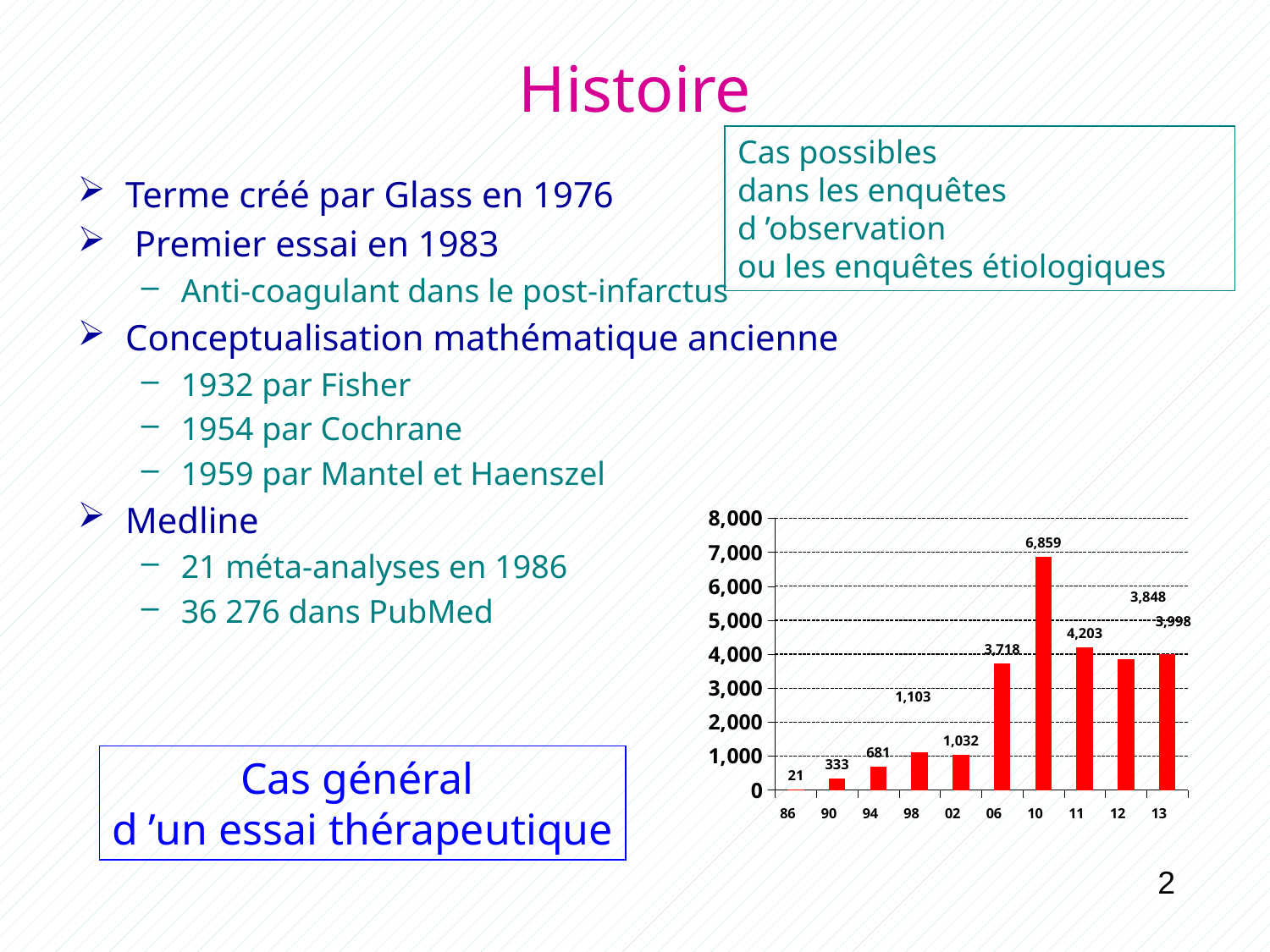
What is the value for the category 86 in the chart? 21 How many bars (categories) does the chart show? 10 What is the value for the category 10 in the chart? 6,859 Which category has the lowest value in the chart? 86 Is the value for 12 greater or less than 3,000? greater What is the difference between the values for 10 and 11 in the chart? 2,656 What type of chart is shown on the slide? bar chart Which category has the highest value in the chart? 10 Which is larger, the value for 98 or the value for 02? 98 What is the value for the category 06 in the chart? 3,718 What is the value for the category 11 in the chart? 4,203 What is the difference between the values for 13 and 12 in the chart? 150